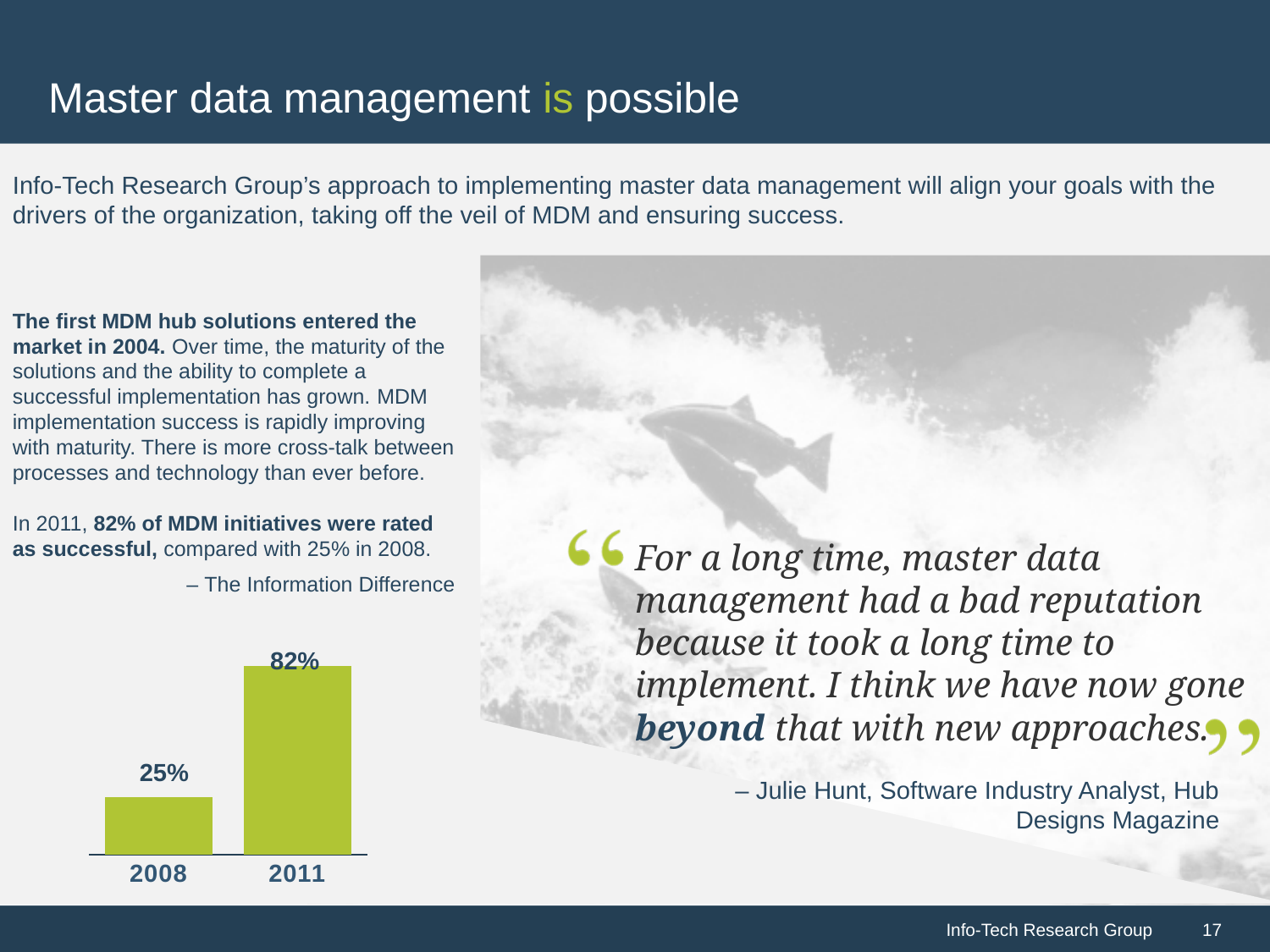
What colour are the bars in the chart? Green What kind of chart is shown on the slide? Bar chart Which years are shown on the x axis of the bar chart? 2008 and 2011 Do the values in the bar chart rise or fall from 2008 to 2011? Rise Which year has the highest value in the bar chart? 2011 What is the value for 2008 in the bar chart? 25% What is the value for 2011 in the bar chart? 82% Which year has the lowest value in the bar chart? 2008 Which is larger in the bar chart, the value for 2008 or the value for 2011? 2011 How many categories are shown in the bar chart? 2 What is the difference between the 2011 and 2008 values in the bar chart? 57%